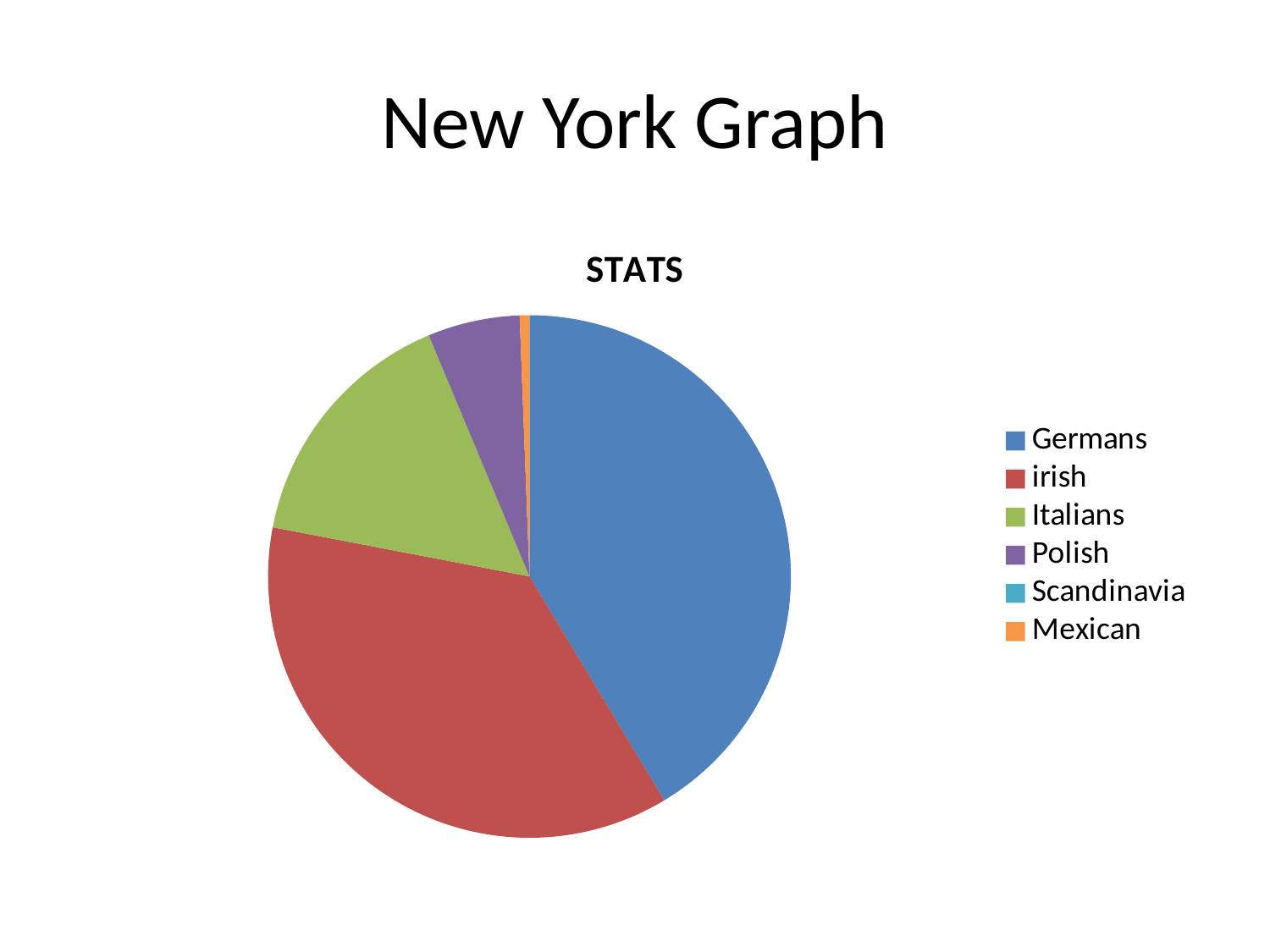
Which category has the largest slice in the STATS pie chart? Germans How many categories does the legend of the STATS pie chart list? 6 What is the title of the pie chart on the slide? STATS Which slice is larger in the STATS pie chart, Germans or irish? Germans Which slice is larger in the STATS pie chart, Polish or Mexican? Polish Which slice is larger in the STATS pie chart, Italians or Polish? Italians What colour is the Germans slice in the STATS pie chart? blue What kind of chart is shown on the slide? pie chart